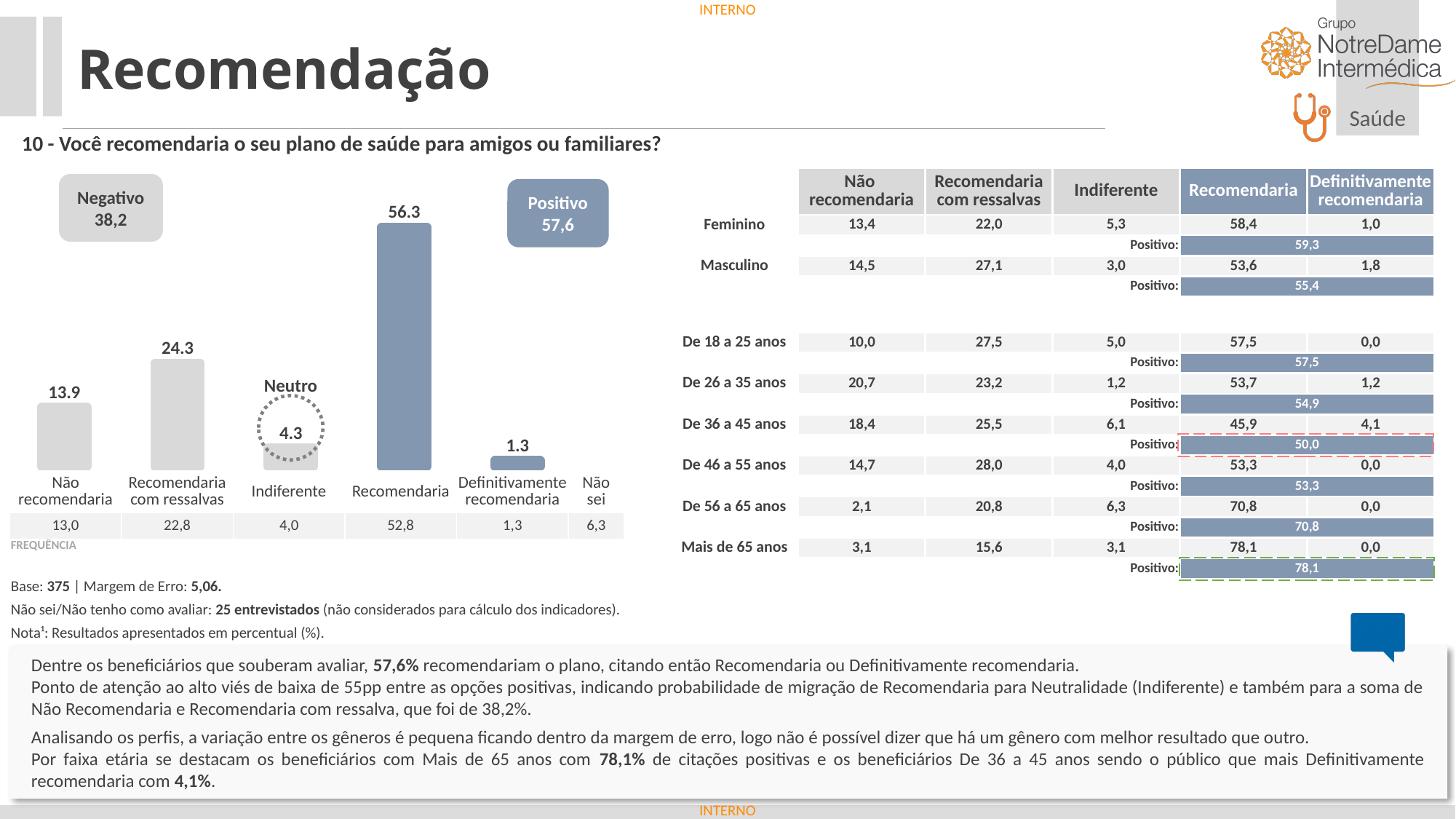
What is the difference between the Recomendaria bar and the Recomendaria com ressalvas bar in the bar chart? 32.0 Which category has the highest bar in the bar chart? Recomendaria Which category has the lowest bar in the bar chart? Definitivamente recomendaria What kind of chart is shown on the left of the slide? Bar chart Which is larger in the bar chart: Não recomendaria or Recomendaria com ressalvas? Recomendaria com ressalvas What is the value of the Definitivamente recomendaria bar in the bar chart? 1.3 What is the difference between the Não recomendaria bar and the Indiferente bar in the bar chart? 9.6 What is the value of the Indiferente bar in the bar chart? 4.3 What value is shown in the Positivo box above the bar chart? 57,6 What is the value of the Recomendaria bar in the bar chart? 56.3 What is the value of the Não recomendaria bar in the bar chart? 13.9 How many bars are plotted in the bar chart? 5